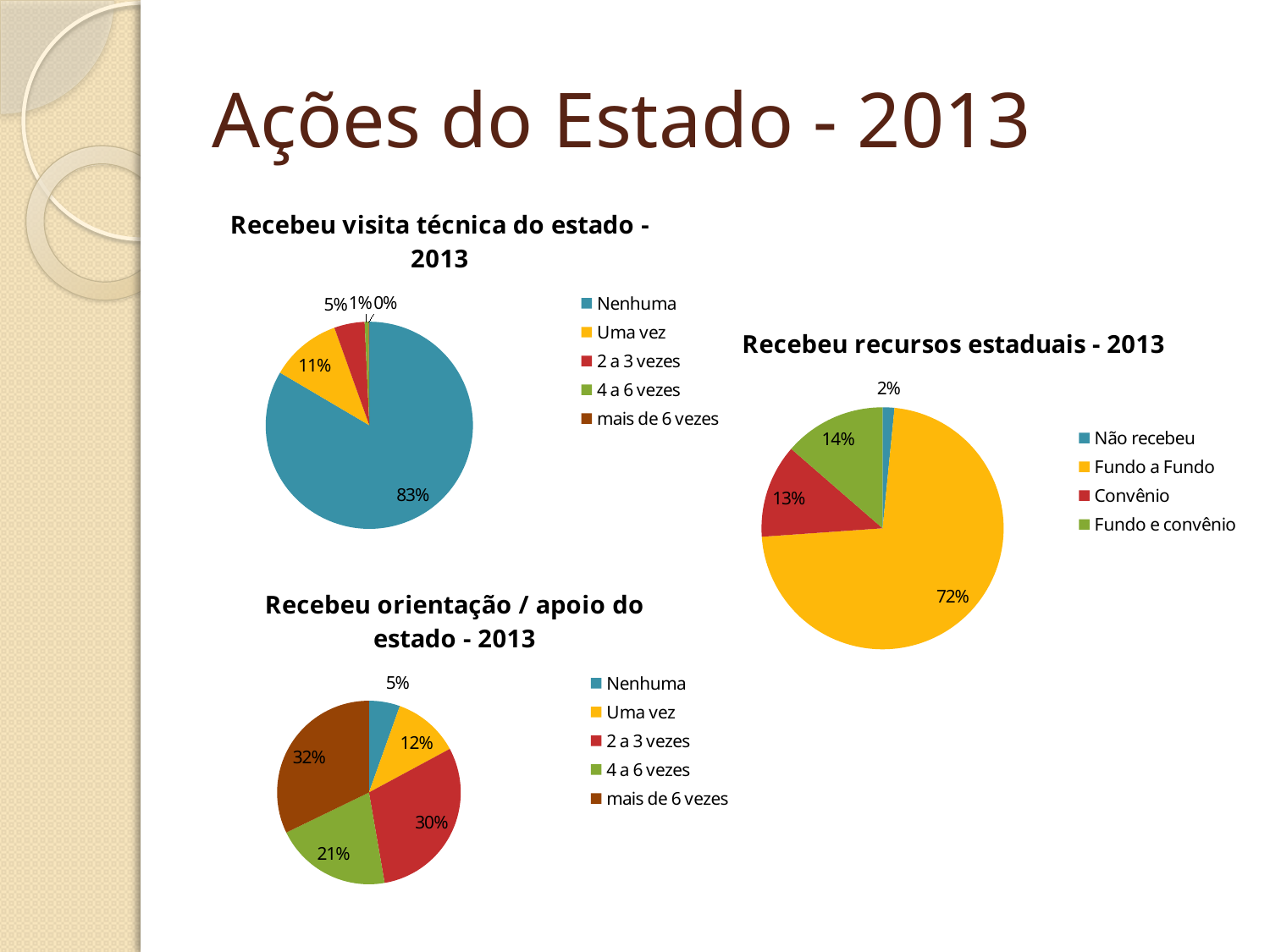
What type of chart is used for 'Recebeu visita técnica do estado - 2013'? Pie chart In the chart 'Recebeu orientação / apoio do estado - 2013', what percentage is shown for '2 a 3 vezes'? 30% In the chart 'Recebeu visita técnica do estado - 2013', what share is labelled for 'Nenhuma'? 83% In the chart 'Recebeu recursos estaduais - 2013', what percentage is shown for 'Fundo a Fundo'? 72% In the chart 'Recebeu visita técnica do estado - 2013', which category has the smallest slice? mais de 6 vezes In the chart 'Recebeu recursos estaduais - 2013', what is the difference between 'Fundo e convênio' and 'Convênio'? 1% In the chart 'Recebeu orientação / apoio do estado - 2013', which is larger: '4 a 6 vezes' or 'Uma vez'? 4 a 6 vezes In the chart 'Recebeu visita técnica do estado - 2013', what percentage is shown for 'Uma vez'? 11% In the chart 'Recebeu orientação / apoio do estado - 2013', which category has the largest share? mais de 6 vezes How many categories does the legend of the chart 'Recebeu recursos estaduais - 2013' list? 4 In the chart 'Recebeu recursos estaduais - 2013', which category has the smallest share? Não recebeu In the chart 'Recebeu orientação / apoio do estado - 2013', what is the difference between 'mais de 6 vezes' and 'Nenhuma'? 27%